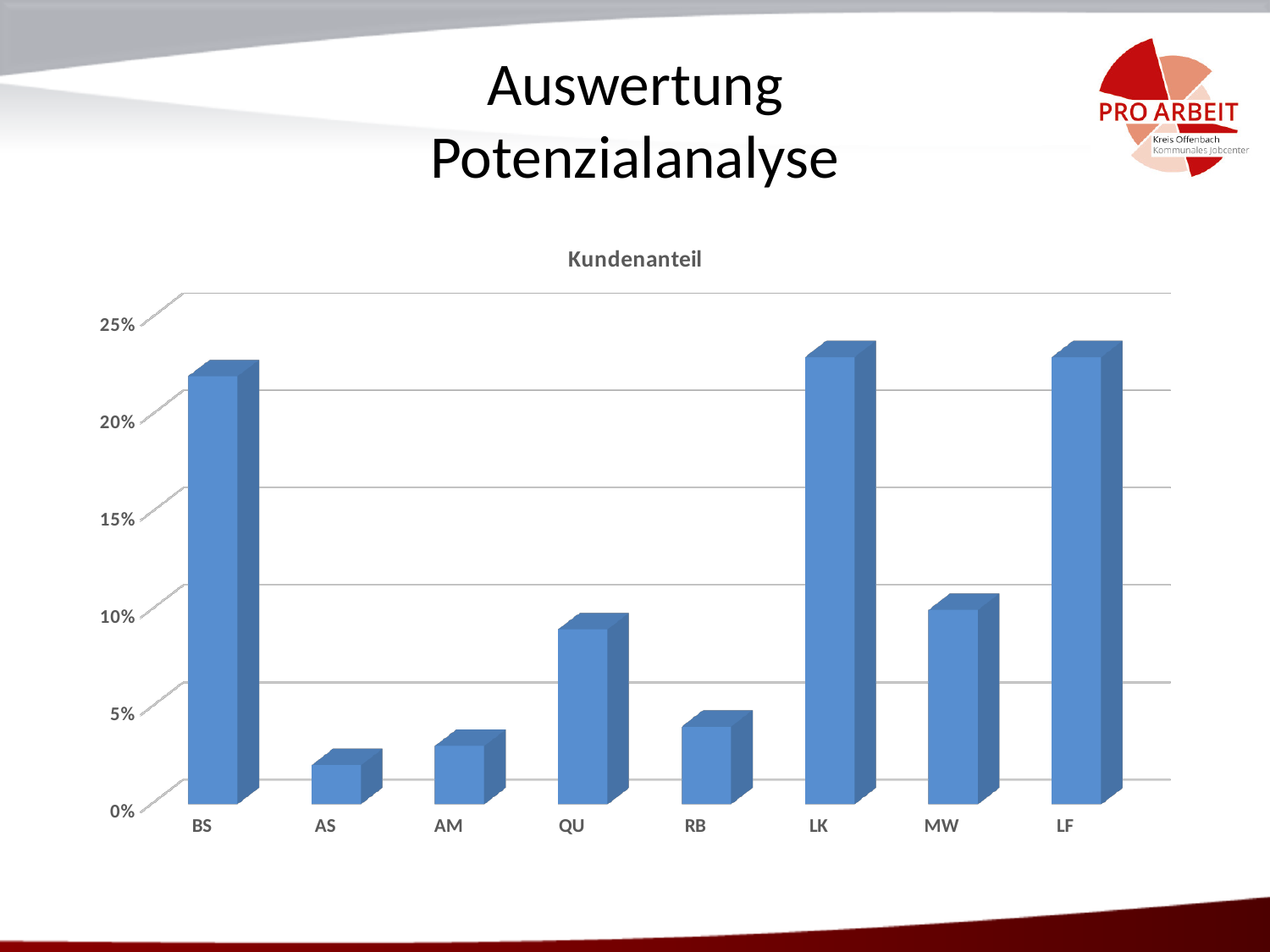
What kind of chart is shown on the slide? bar chart Is the value for LK greater or less than 20%? greater Which has the larger value, RB or LF? LF Is the value for AS greater or less than 5%? less Which category has the lowest value in the chart? AS Is the value for MW greater or less than 15%? less What is the title of the chart? Kundenanteil Which has the larger value, MW or AM? MW Which has the larger value, BS or QU? BS How many categories are shown on the x axis of the chart? 8